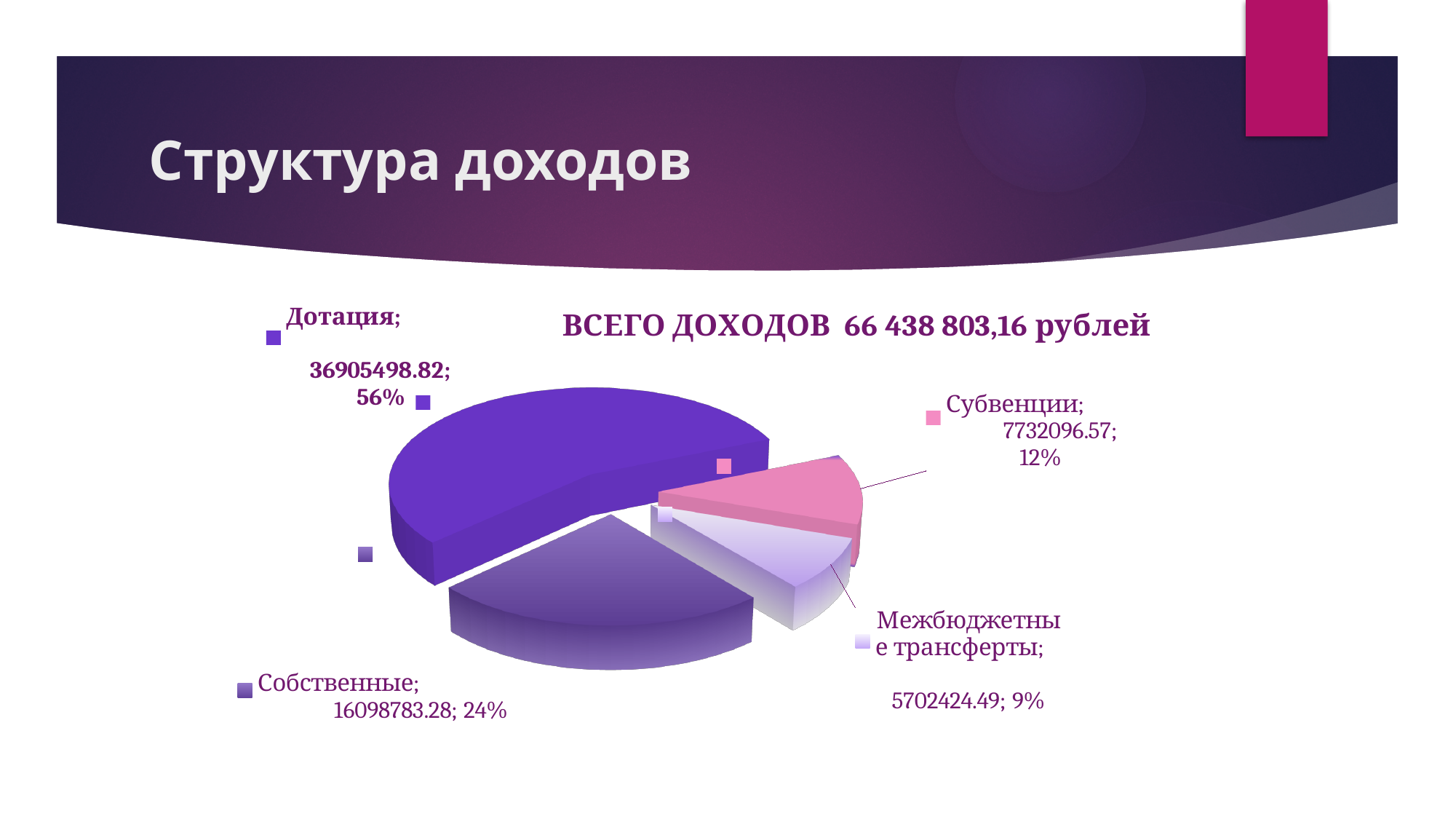
Which is larger, the value for Собственные or the value for Субвенции? Собственные What share of the pie does Межбюджетные трансферты represent? 9% What is the value shown for Межбюджетные трансферты? 5702424.49 What is the value shown for Собственные? 16098783.28 How many slices does the pie chart have? 4 Which category has the smallest slice of the pie? Межбюджетные трансферты What is the value shown for Дотация? 36905498.82 What is the value shown for Субвенции? 7732096.57 Which category has the largest slice of the pie? Дотация What share of the pie does Дотация represent? 56% What kind of chart is shown on the slide? Pie chart